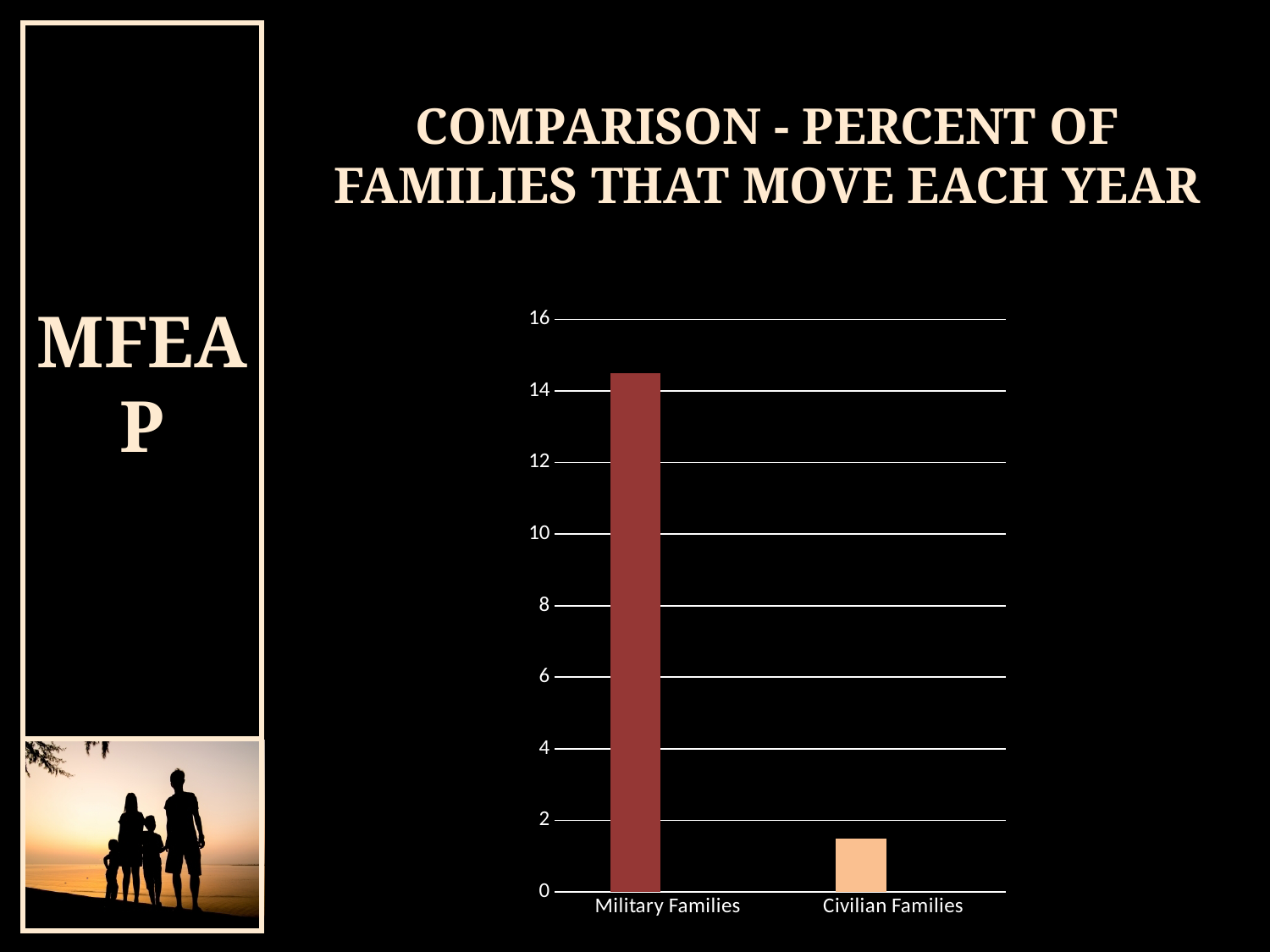
Is the value for Civilian Families greater or less than 4? less Is the value for Military Families greater or less than 10? greater What is the title of the chart on the slide? COMPARISON - PERCENT OF FAMILIES THAT MOVE EACH YEAR What is the highest value shown on the vertical axis of the chart? 16 Is the value for Civilian Families greater or less than 2? less Which is larger, the value for Military Families or the value for Civilian Families? Military Families Which category has the lowest value in the chart? Civilian Families What kind of chart is shown on the slide? bar chart Which category has the highest value in the chart? Military Families How many categories are plotted in the chart? 2